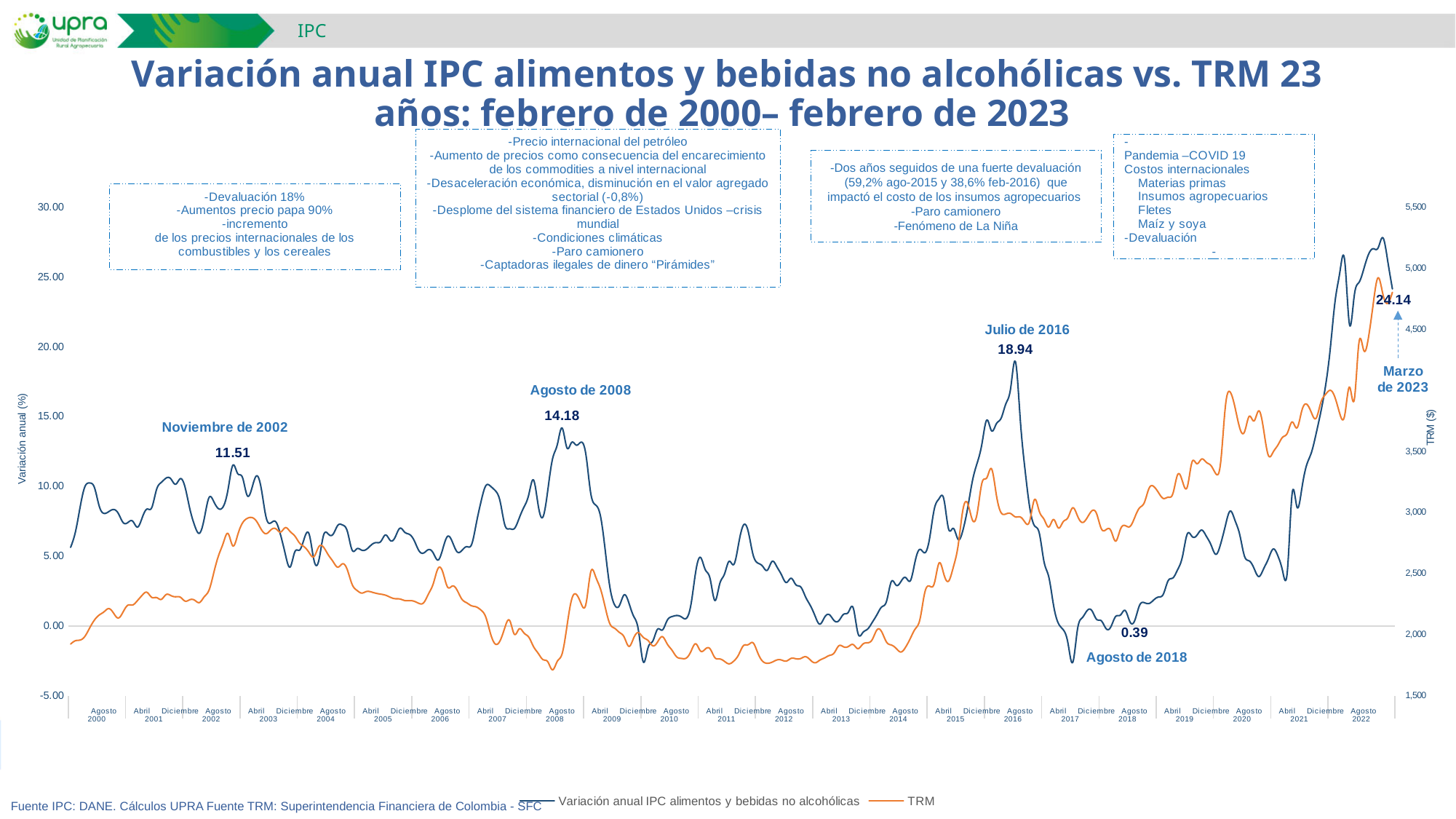
How many series does the legend list? 2 Which labeled point has the highest annual IPC variation? Marzo de 2023 What is the labeled value of the annual IPC variation for Agosto de 2018? 0.39 What is the difference between the labeled values for Julio de 2016 and Agosto de 2008? 4.76 What is the labeled value of the annual IPC variation for Marzo de 2023? 24.14 Which labeled value is larger: Agosto de 2008 or Noviembre de 2002? Agosto de 2008 What is the labeled value of the annual IPC variation for Noviembre de 2002? 11.51 What type of chart is shown on the slide? line chart What is the labeled value of the annual IPC variation for Agosto de 2008? 14.18 Is the TRM value at the start of the series (Agosto 2000) greater or less than 2,500? less What is the labeled value of the annual IPC variation for Julio de 2016? 18.94 Which labeled point has the lowest annual IPC variation? Agosto de 2018